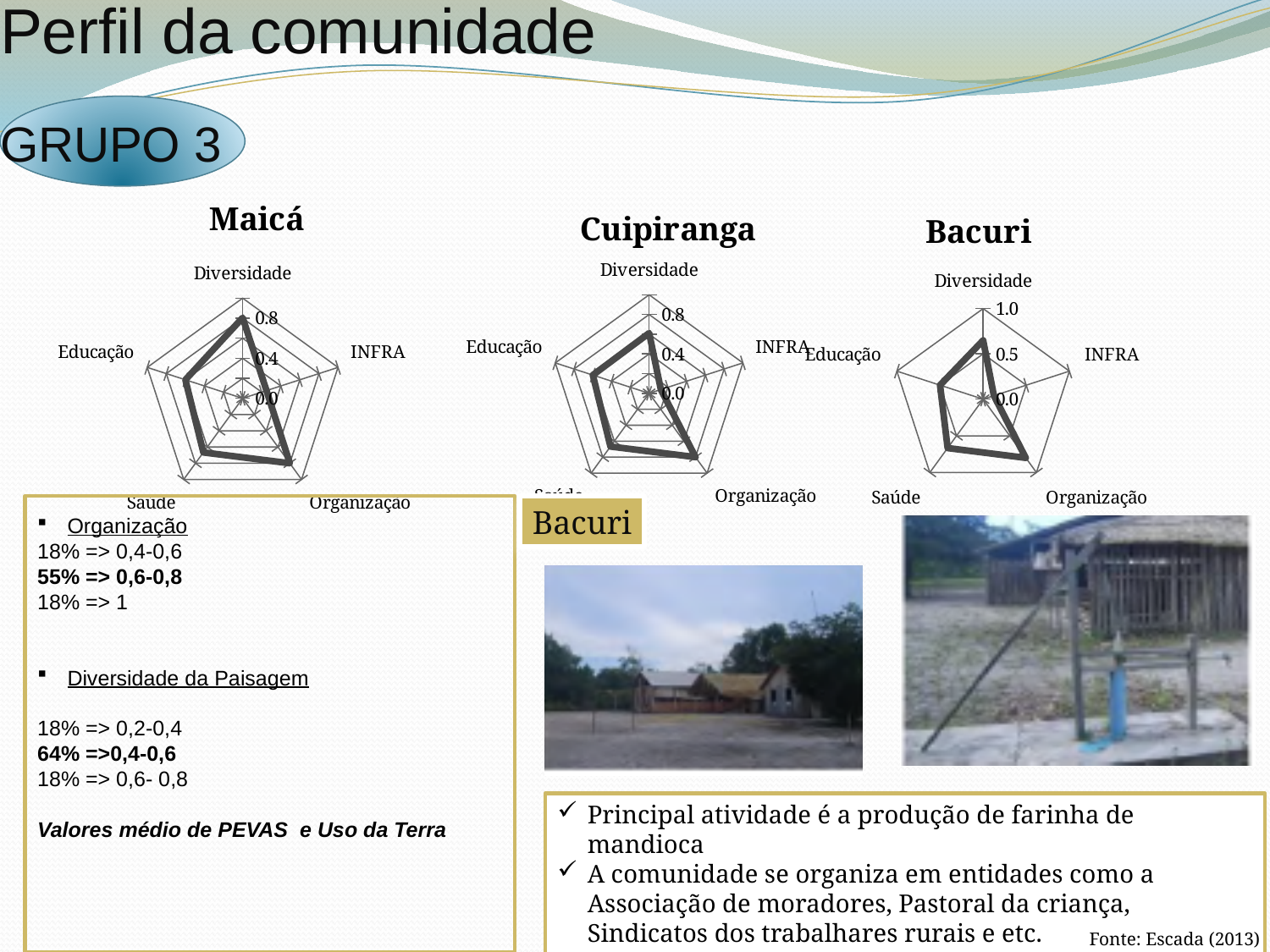
In the Maicá chart, how many axes (categories) does the radar have? 5 How many radar charts are shown on the slide? 3 In the Bacuri chart, which category has the lowest value? INFRA In the Cuipiranga chart, which category has the lowest value? INFRA In the Maicá chart, which category has the lowest value? INFRA In the Bacuri chart, is the value for Organização greater or less than 0.5? greater In the Cuipiranga chart, which is larger, the value for Organização or the value for INFRA? Organização In the Maicá chart, is the value for Educação greater or less than 0.4? greater In the Cuipiranga chart, is the value for Organização greater or less than 0.4? greater What kind of chart is the Maicá chart? radar chart In the Bacuri chart, what is the highest tick value shown on the radial axis? 1.0